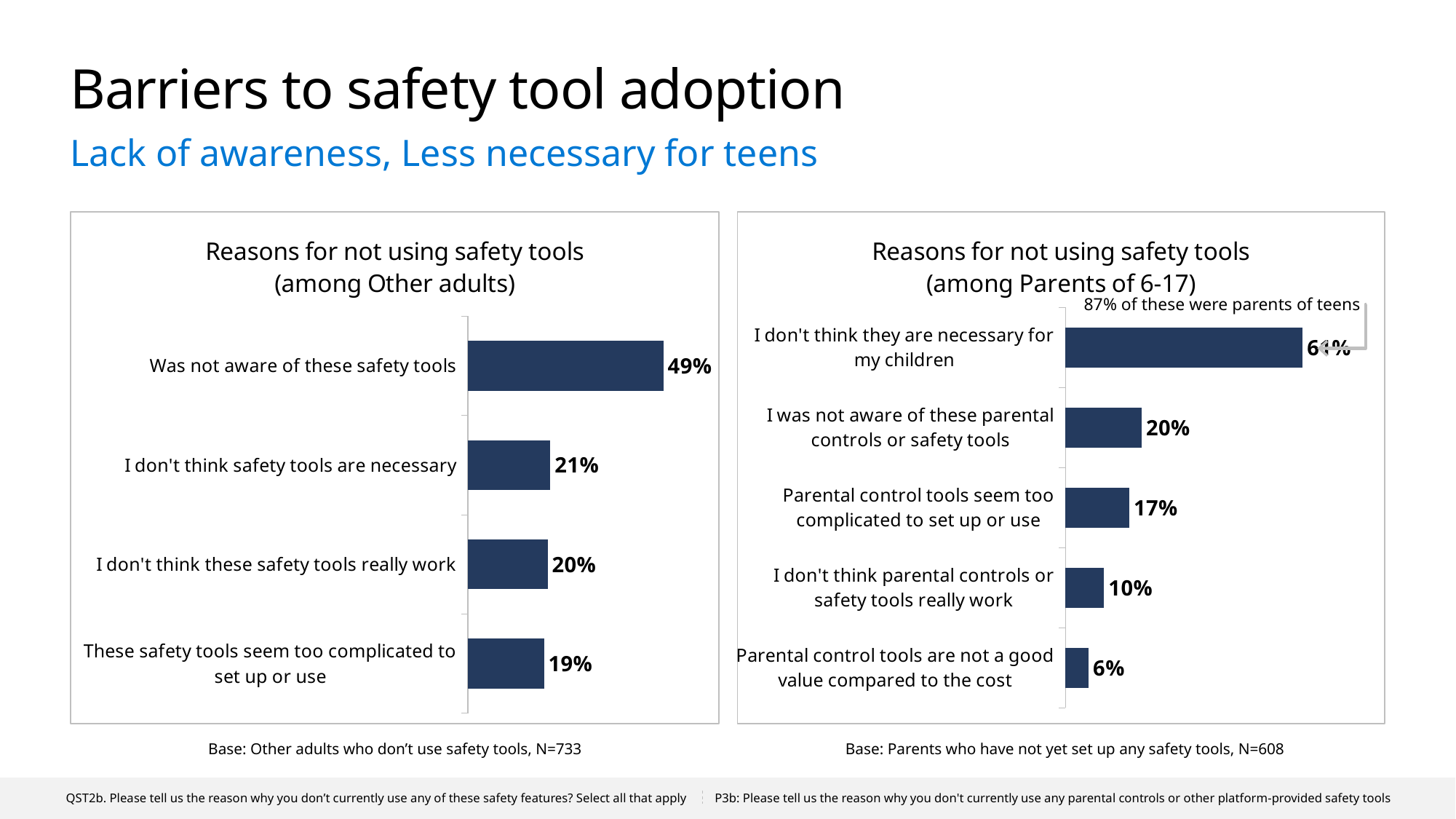
In the chart 'Reasons for not using safety tools (among Parents of 6-17)', what is the value for 'I was not aware of these parental controls or safety tools'? 20% In the chart 'Reasons for not using safety tools (among Other adults)', what is the difference between 'Was not aware of these safety tools' and 'I don't think safety tools are necessary'? 28 percentage points In the chart 'Reasons for not using safety tools (among Parents of 6-17)', which reason has the highest value? I don't think they are necessary for my children In the chart 'Reasons for not using safety tools (among Other adults)', what percentage was not aware of these safety tools? 49% In the chart 'Reasons for not using safety tools (among Parents of 6-17)', what is the difference between 'I don't think parental controls or safety tools really work' and 'Parental control tools are not a good value compared to the cost'? 4 percentage points What type of chart is used on the left side of the slide? Bar chart In the chart 'Reasons for not using safety tools (among Parents of 6-17)', which reason has the lowest value? Parental control tools are not a good value compared to the cost How many reasons are shown in the chart 'Reasons for not using safety tools (among Other adults)'? 4 In the chart 'Reasons for not using safety tools (among Parents of 6-17)', what percentage said parental control tools seem too complicated to set up or use? 17% In the chart 'Reasons for not using safety tools (among Other adults)', which reason has the lowest value? These safety tools seem too complicated to set up or use How many reasons are shown in the chart 'Reasons for not using safety tools (among Parents of 6-17)'? 5 In the chart 'Reasons for not using safety tools (among Other adults)', what is the value for 'I don't think safety tools are necessary'? 21%